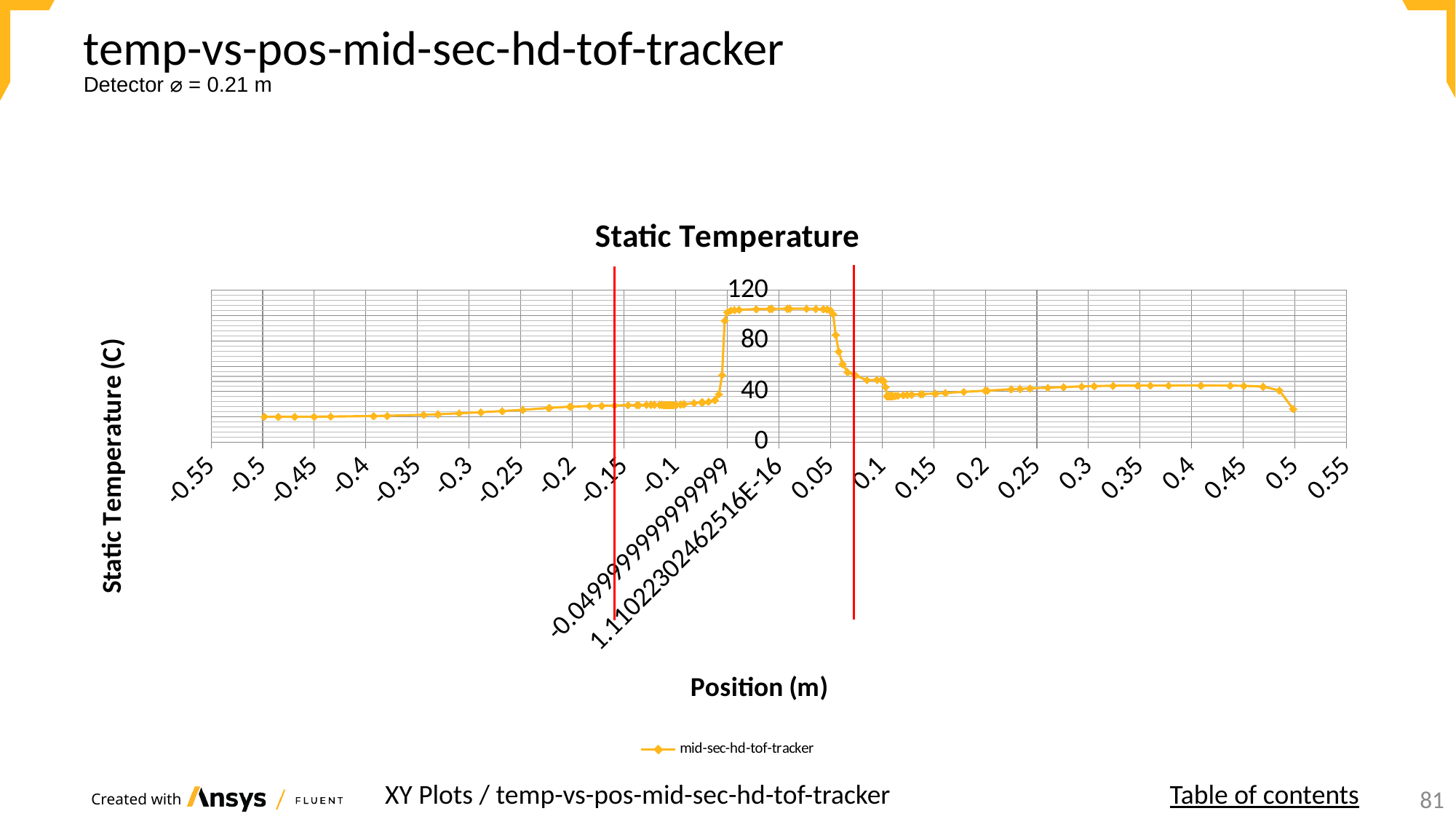
What kind of chart is shown on the slide? line chart Is the value for position -0.5 greater or less than 40? less Is the value for position 0.05 greater or less than 80? greater What is the name of the series shown in the legend? mid-sec-hd-tof-tracker Which is larger, the value at position -0.5 or the value at position 0.4? 0.4 Is the value for position -0.3 greater or less than 40? less Do the values rise or fall along the x axis from position -0.5 to position -0.15? rise What is the title of the chart? Static Temperature How many series does the legend list? 1 Which is larger, the value at position 0.05 or the value at position 0.3? 0.05